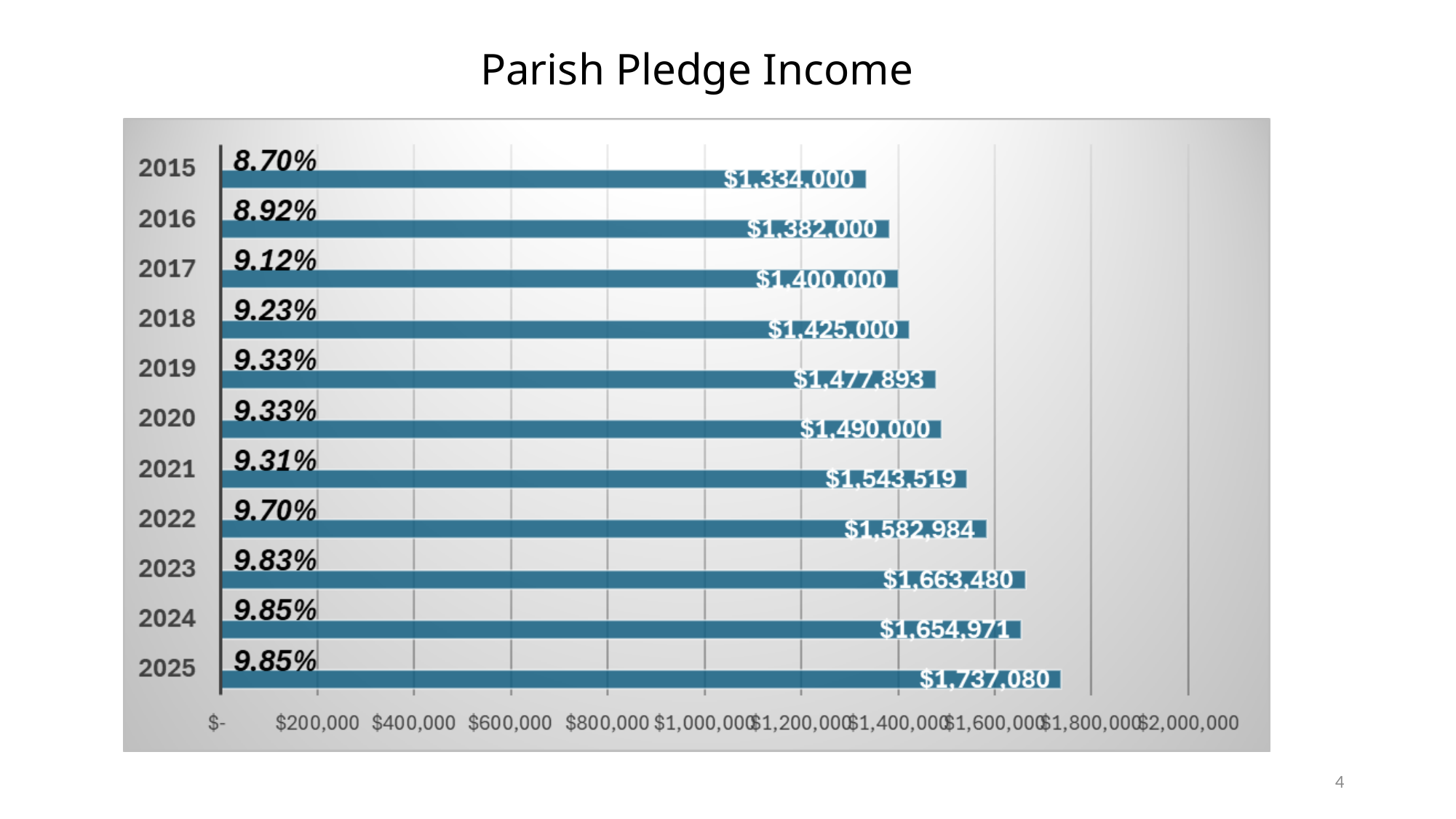
How many years are shown on the chart? 11 Which year has the larger pledge income, 2023 or 2024? 2023 What is the pledge income value shown for 2025? $1,737,080 What percentage is printed next to the 2015 bar? 8.70% What is the pledge income value shown for 2019? $1,477,893 Is the value for 2021 greater or less than $1,400,000? greater Which year has the lowest pledge income? 2015 What kind of chart is shown on the slide? bar chart What is the difference between the pledge income for 2023 and 2024? $8,509 What is the title of the chart? Parish Pledge Income What is the difference between the pledge income for 2025 and 2015? $403,080 Which year has the highest pledge income? 2025